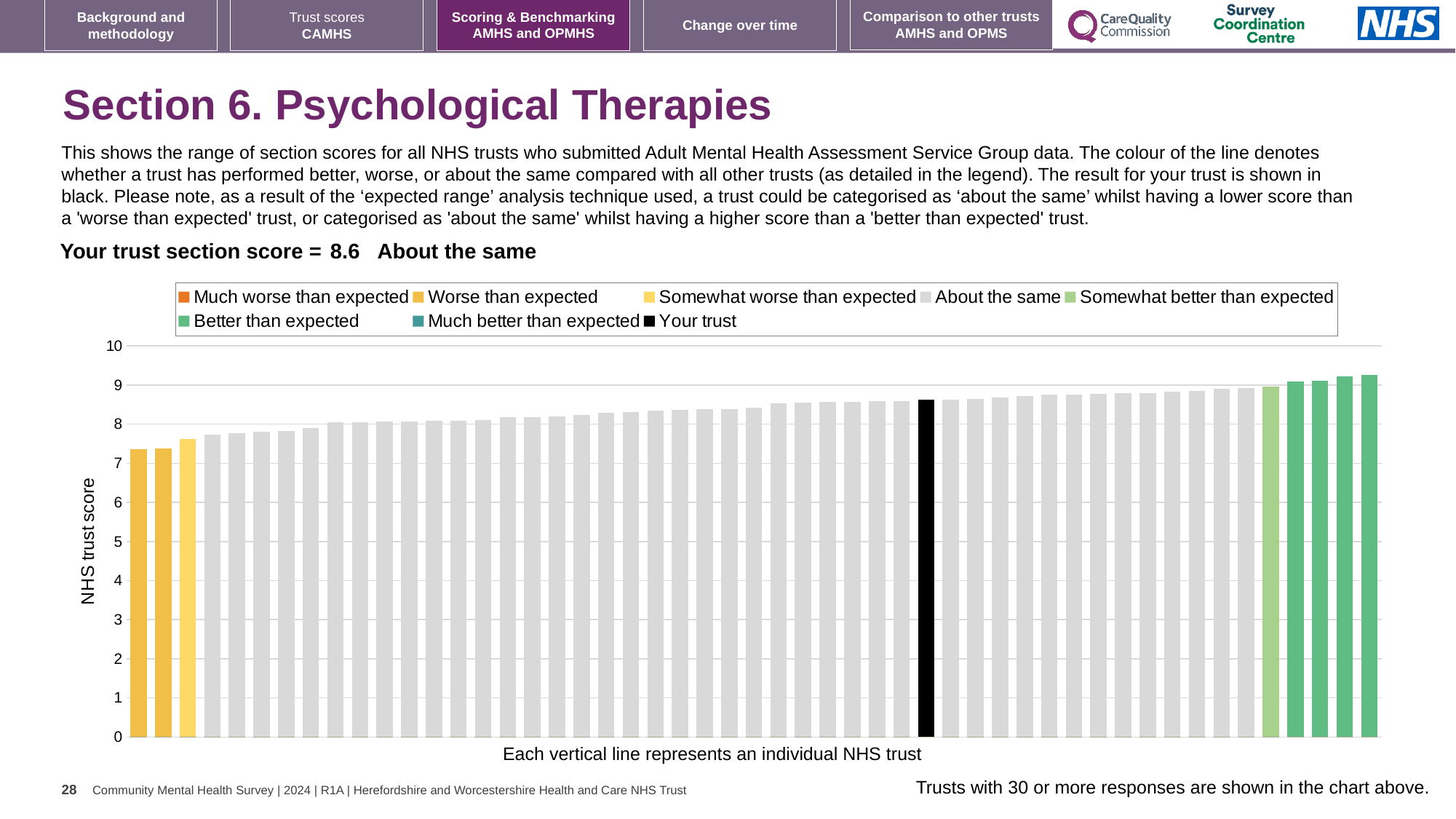
Which legend category does the highest bar in the chart belong to? Better than expected How many bars are coloured as 'Worse than expected'? 2 Is the value of the rightmost (highest) bar greater or less than 9? greater Is the value of the black 'Your trust' bar greater or less than 8? greater How many bars are coloured as 'Better than expected'? 4 What is the label on the vertical axis of the chart? NHS trust score How many entries does the chart legend list? 8 Do the bar values rise or fall from left to right along the x axis? Rise Is the value of the leftmost (lowest) bar greater or less than 7? greater What is the section score for your trust shown on the slide? 8.6 Which is larger: the black 'Your trust' bar or the leftmost bar? The black 'Your trust' bar What kind of chart is shown on the slide? Bar chart